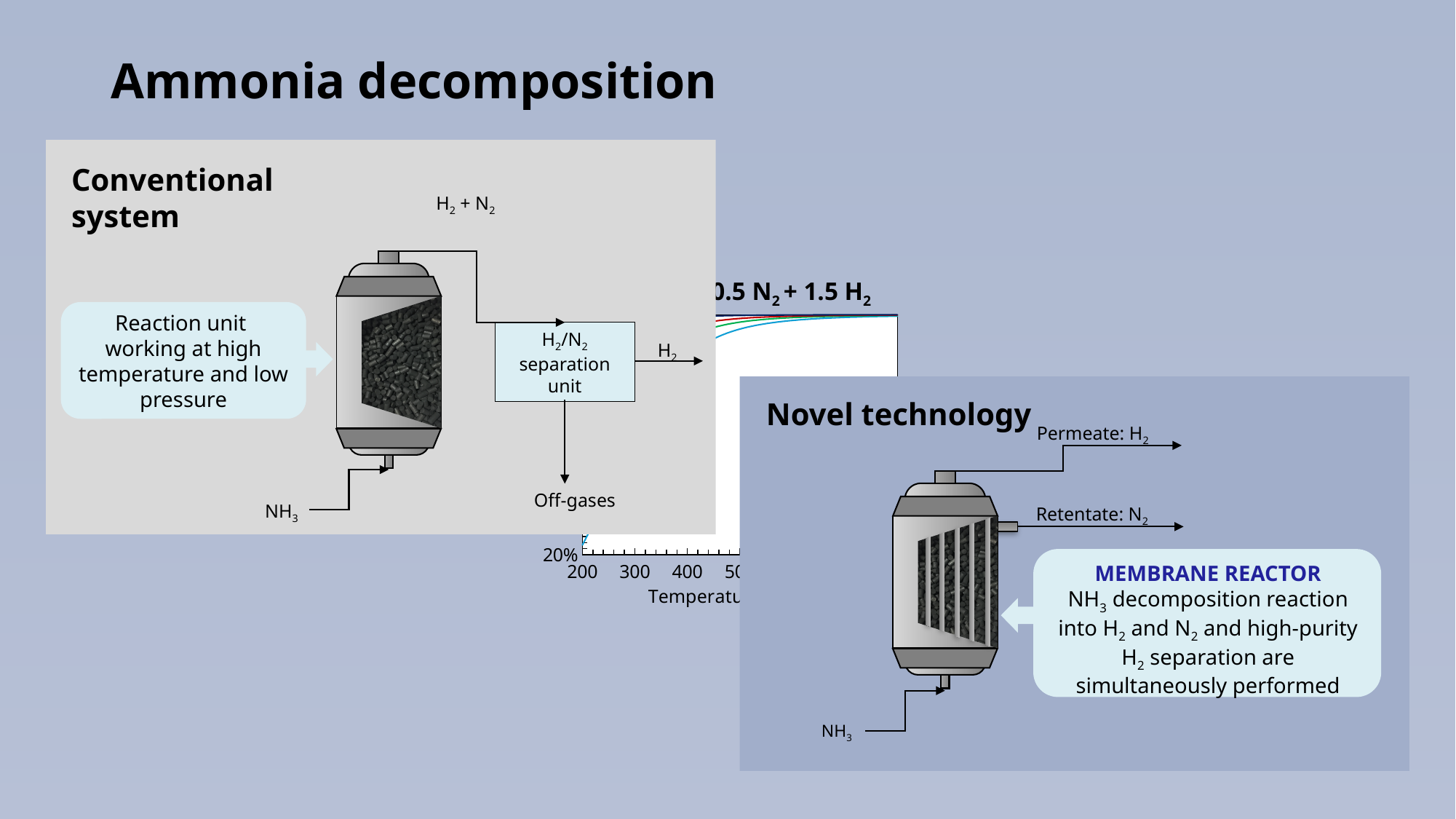
In the partially visible chart, do the plotted curves rise or fall as temperature increases along the x axis? rise What is the y-axis tick label visible at the bottom of the partially visible chart? 20% What is the lowest tick label shown on the x axis of the partially visible chart? 200 What kind of chart is partially visible behind the two system panels? line chart